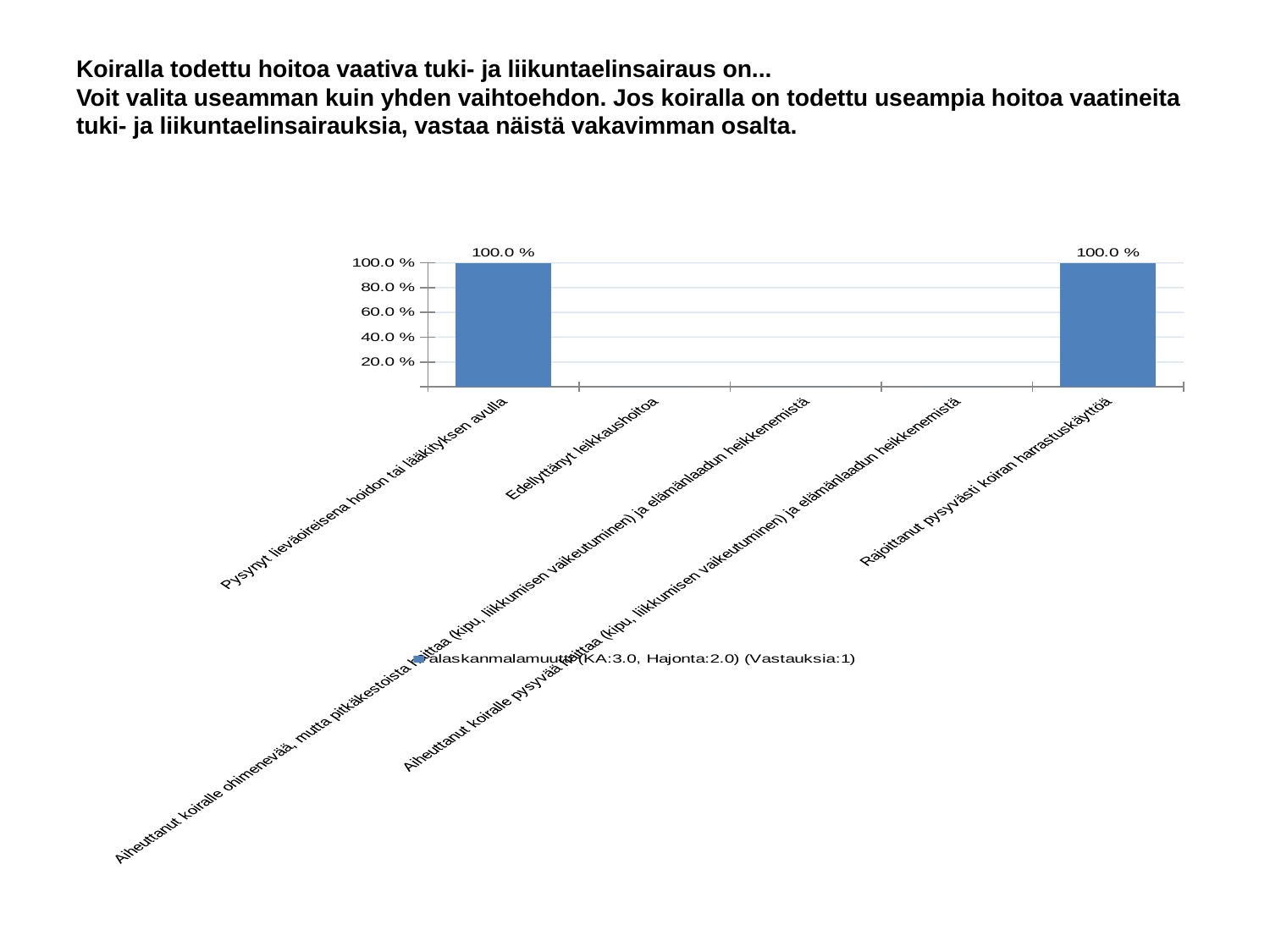
How many bars are actually drawn in the chart? 2 How many categories are shown on the x axis of the chart? 5 How many series does the legend list? 1 What is the difference between the value for "Pysynyt lieväoireisena hoidon tai lääkityksen avulla" and the value for "Rajoittanut pysyvästi koiran harrastuskäyttöä"? 0.0 % What colour are the bars in the chart? Blue What is the value for "Pysynyt lieväoireisena hoidon tai lääkityksen avulla"? 100.0 % What is the highest tick label shown on the y axis? 100.0 % Which is larger, the value for "Pysynyt lieväoireisena hoidon tai lääkityksen avulla" or the value for "Edellyttänyt leikkaushoitoa"? Pysynyt lieväoireisena hoidon tai lääkityksen avulla Is the value for "Rajoittanut pysyvästi koiran harrastuskäyttöä" greater or less than 80.0 %? greater What is the value for "Rajoittanut pysyvästi koiran harrastuskäyttöä"? 100.0 % Is the value for "Edellyttänyt leikkaushoitoa" greater or less than 20.0 %? less What kind of chart is shown on the slide? Bar chart